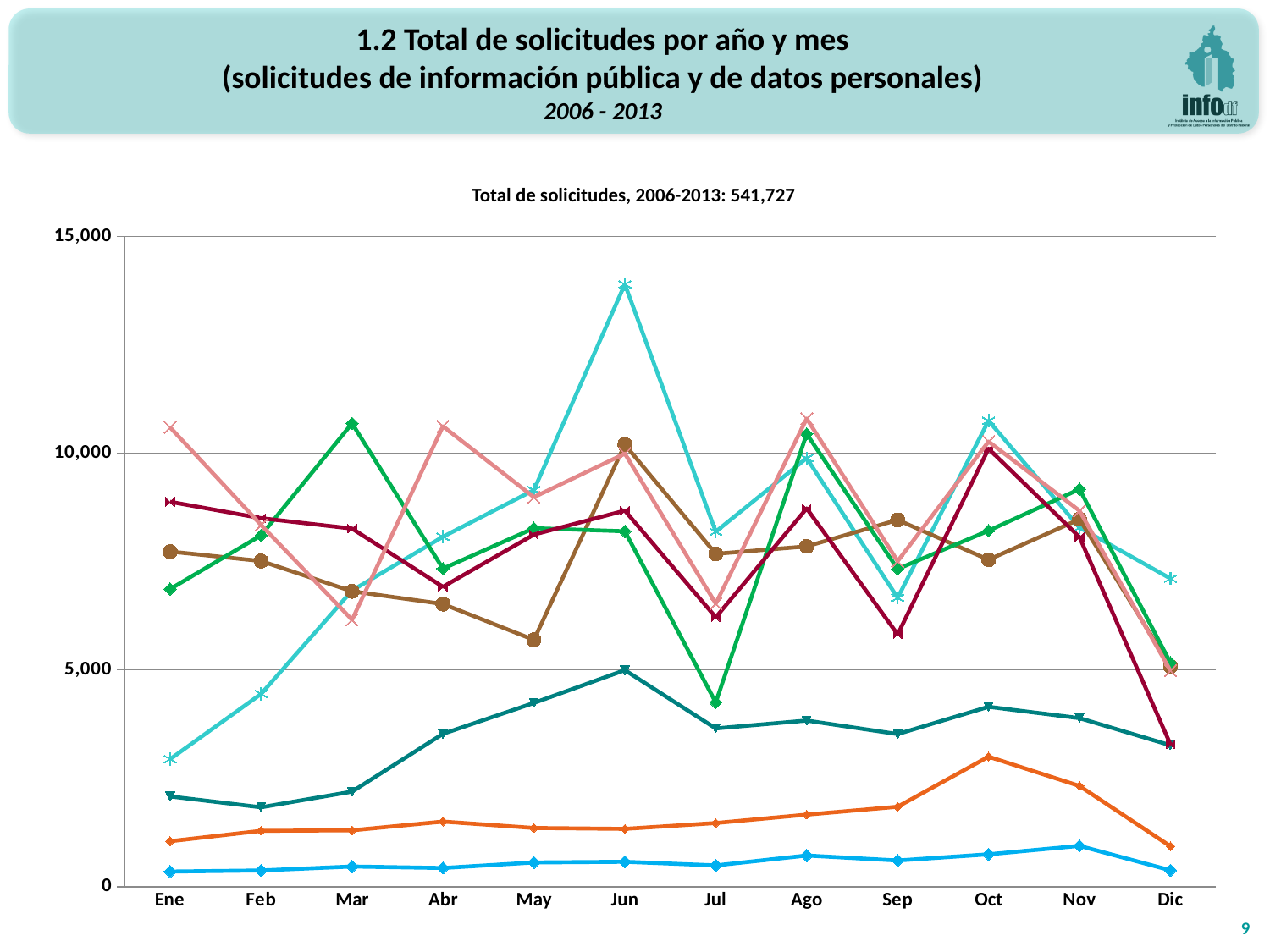
What is the last month shown on the x axis of the chart? Dic What is the first month shown on the x axis of the chart? Ene Is the highest point on the chart, in Jun, greater or less than 10,000? greater How many months are shown along the x axis of the chart? 12 What is the highest value shown on the y axis of the chart? 15,000 What kind of chart is shown on the slide? line chart In which month does the highest point on the chart occur? Jun What is the total number of solicitudes for 2006-2013 stated above the chart? 541,727 What is the title printed directly above the chart? Total de solicitudes, 2006-2013: 541,727 How many lines are plotted on the chart? 8